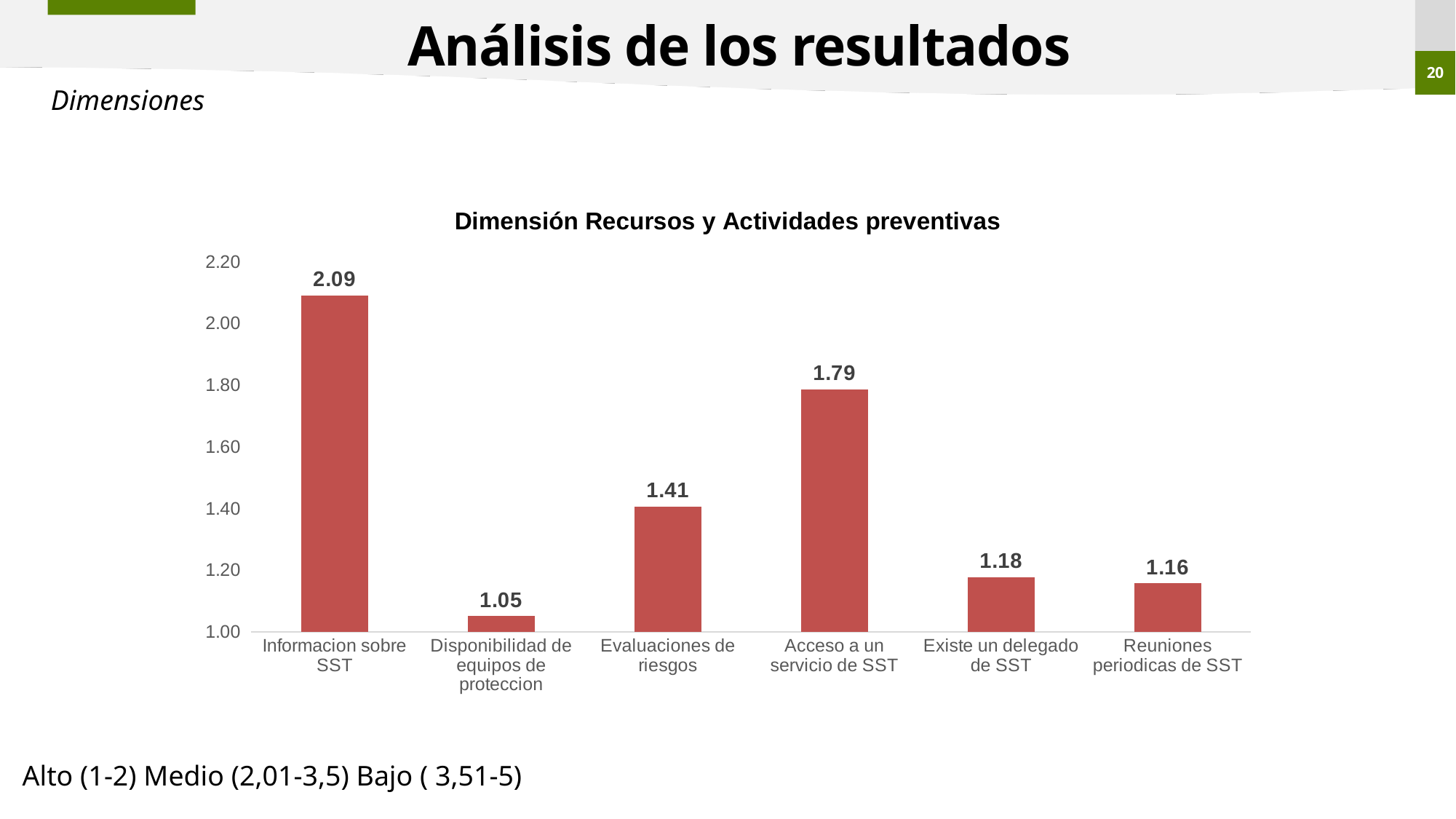
What is the title of the chart? Dimensión Recursos y Actividades preventivas Is the value for Evaluaciones de riesgos greater or less than 1.60? less What is the value for Disponibilidad de equipos de proteccion? 1.05 How many categories are shown in the chart? 6 What is the difference between the values for Informacion sobre SST and Acceso a un servicio de SST? 0.30 What kind of chart is shown on the slide? bar chart What is the value for Reuniones periodicas de SST? 1.16 Which category has the lowest value? Disponibilidad de equipos de proteccion Which category has the highest value? Informacion sobre SST What is the value for Informacion sobre SST? 2.09 What is the value for Acceso a un servicio de SST? 1.79 Which is larger, the value for Evaluaciones de riesgos or the value for Existe un delegado de SST? Evaluaciones de riesgos